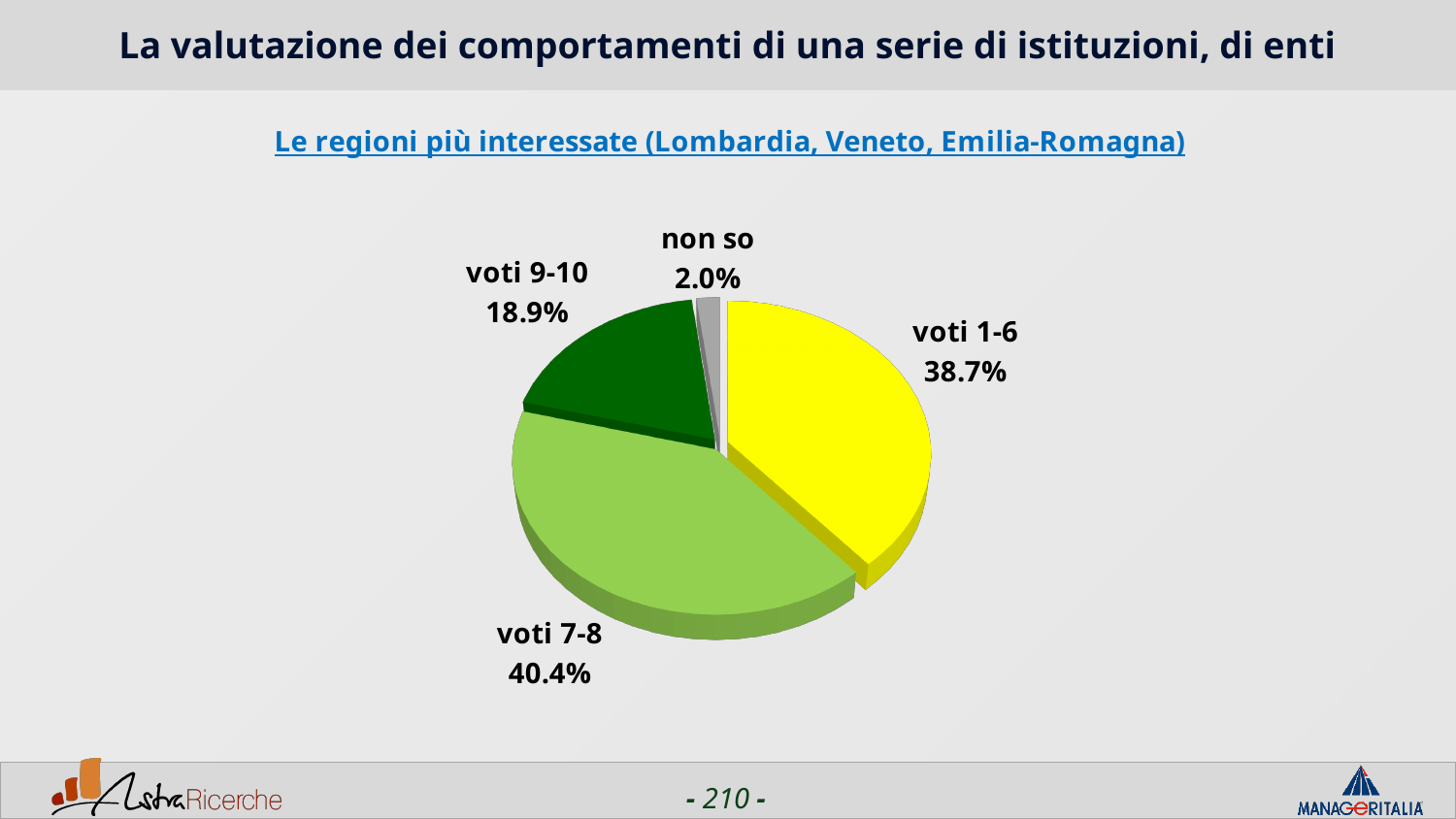
What is the difference in percentage points between 'voti 1-6' and 'voti 9-10'? 19.8 What percentage of respondents answered 'non so'? 2.0% What percentage of respondents gave 'voti 1-6'? 38.7% Which is larger, the share for 'voti 9-10' or the share for 'non so'? voti 9-10 What type of chart is shown on the slide? pie chart Which category has the smallest share of the pie? non so What percentage of respondents gave 'voti 7-8'? 40.4% How many slices does the pie chart have? 4 What percentage of respondents gave 'voti 9-10'? 18.9% What colour is the 'voti 1-6' slice? yellow Which category has the largest share of the pie? voti 7-8 What is the difference in percentage points between 'voti 7-8' and 'voti 1-6'? 1.7